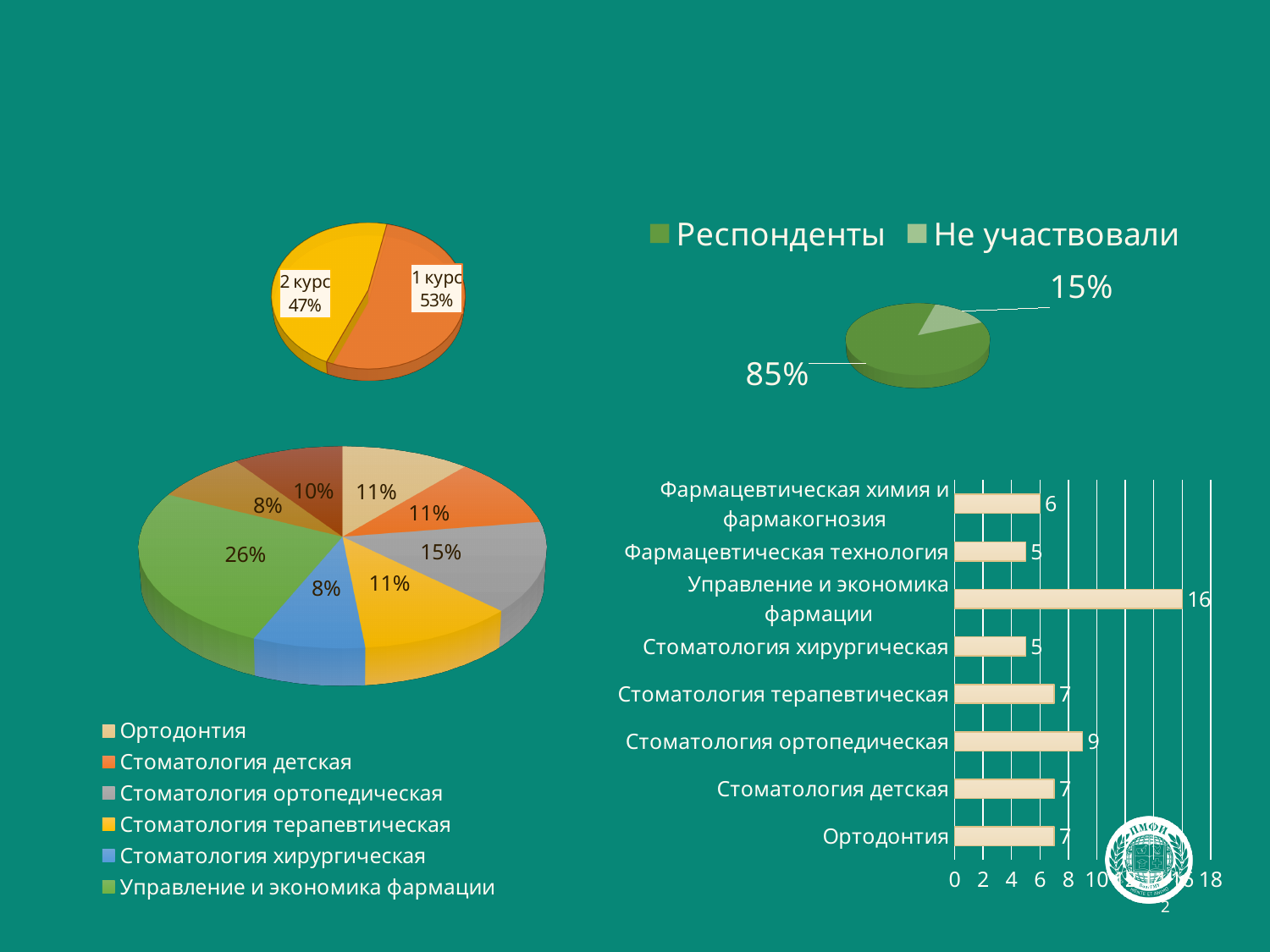
In the top-right pie chart, how many entries does the legend list? 2 In the top-left pie chart, what share is shown for 2 курс? 47% What kind of chart is the bottom-right chart? Bar chart In the top-right pie chart, what share is shown for Не участвовали? 15% In the bottom-left pie chart, what share is shown for Стоматология ортопедическая? 15% In the bottom-right bar chart, what is the value for Управление и экономика фармации? 16 In the top-right pie chart, what share is shown for Респонденты? 85% In the bottom-right bar chart, which category has the highest value? Управление и экономика фармации In the bottom-right bar chart, how many categories are shown? 8 In the bottom-right bar chart, what is the difference between Стоматология ортопедическая and Фармацевтическая технология? 4 In the top-left pie chart, what share is shown for 1 курс? 53%